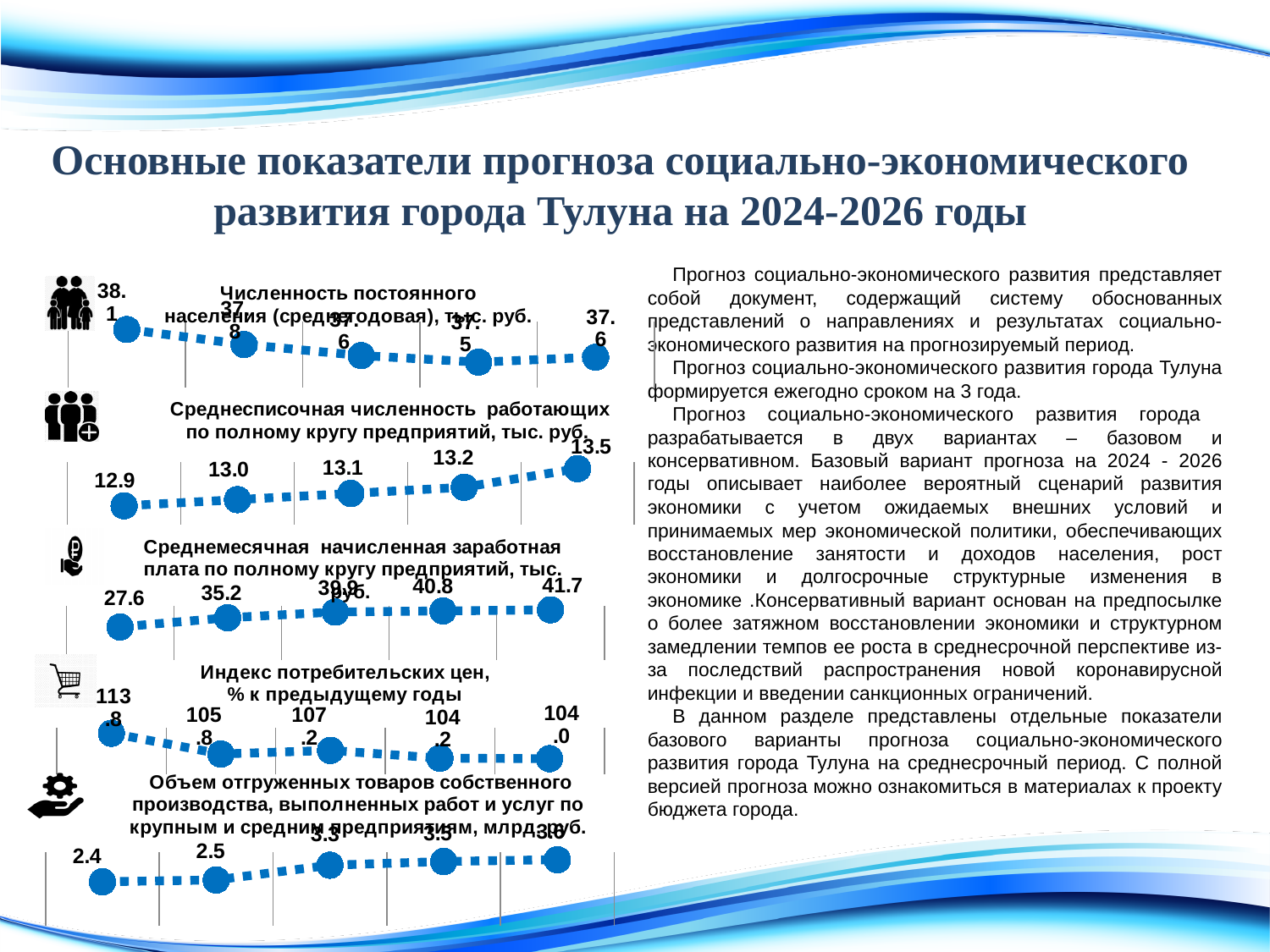
In the chart 'Среднесписочная численность работающих по полному кругу предприятий', what is the value of the last (rightmost) point? 13.5 What kind of chart is used for 'Среднесписочная численность работающих по полному кругу предприятий'? line chart In the chart 'Индекс потребительских цен, % к предыдущему году', what is the value of the first (leftmost) point? 113.8 In the chart 'Объем отгруженных товаров собственного производства', which is larger: the first point (2.4) or the second point (2.5)? 2.5 In the chart 'Численность постоянного населения (среднегодовая)', what is the value of the first (leftmost) point? 38.1 In the chart 'Среднемесячная начисленная заработная плата по полному кругу предприятий', what is the difference between the last value (41.7) and the first value (27.6)? 14.1 In the chart 'Среднесписочная численность работающих по полному кругу предприятий', what is the value of the first (leftmost) point? 12.9 How many data points are plotted in the chart 'Индекс потребительских цен, % к предыдущему году'? 5 In the chart 'Индекс потребительских цен, % к предыдущему году', what is the value of the last (rightmost) point? 104.0 In the chart 'Среднемесячная начисленная заработная плата по полному кругу предприятий', what is the highest value shown? 41.7 In the chart 'Среднемесячная начисленная заработная плата по полному кругу предприятий', what is the lowest value shown? 27.6 In the chart 'Среднесписочная численность работающих по полному кругу предприятий', do the values rise or fall from left to right? rise